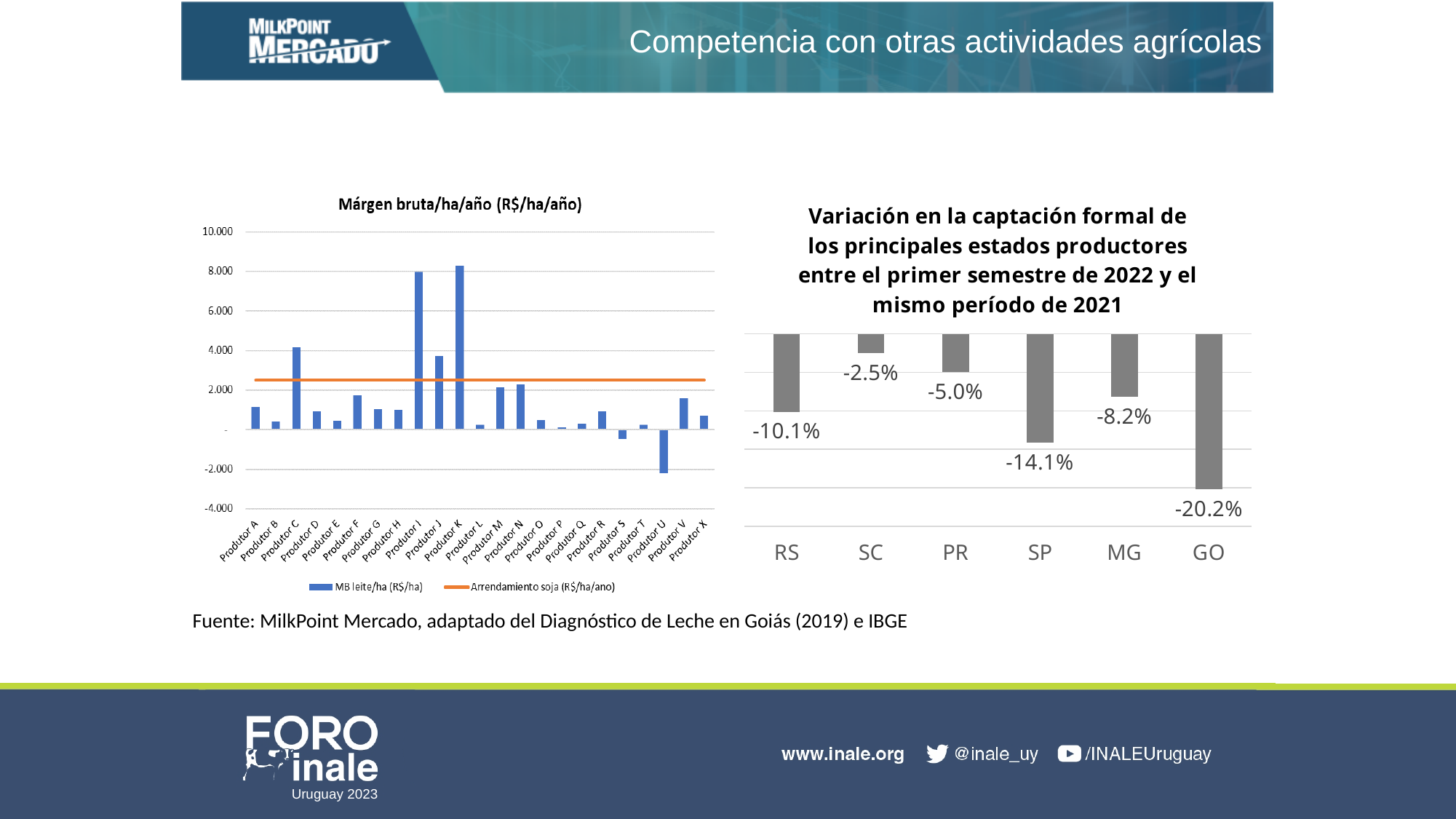
In the chart 'Variación en la captación formal de los principales estados productores', which state shows the largest decline? GO In the chart 'Variación en la captación formal de los principales estados productores', what is the value for SC? -2.5% In the chart 'Variación en la captación formal de los principales estados productores', what is the value for GO? -20.2% In the chart 'Márgen bruta/ha/año (R$/ha/año)', how many producers are shown on the x axis? 23 In the chart 'Márgen bruta/ha/año (R$/ha/año)', is the value for Produtor K greater or less than 6.000? greater In the chart 'Variación en la captación formal de los principales estados productores', how many states are shown? 6 In the chart 'Variación en la captación formal de los principales estados productores', which state shows the smallest decline? SC In the chart 'Márgen bruta/ha/año (R$/ha/año)', how many series does the legend list? 2 In the chart 'Márgen bruta/ha/año (R$/ha/año)', which producer has the lowest margin? Produtor U In the chart 'Variación en la captación formal de los principales estados productores', what is the value for SP? -14.1% In the chart 'Variación en la captación formal de los principales estados productores', what is the difference in percentage points between the values for RS and SC? 7.6 percentage points In the chart 'Márgen bruta/ha/año (R$/ha/año)', what does the orange line represent according to the legend? Arrendamiento soja (R$/ha/ano)